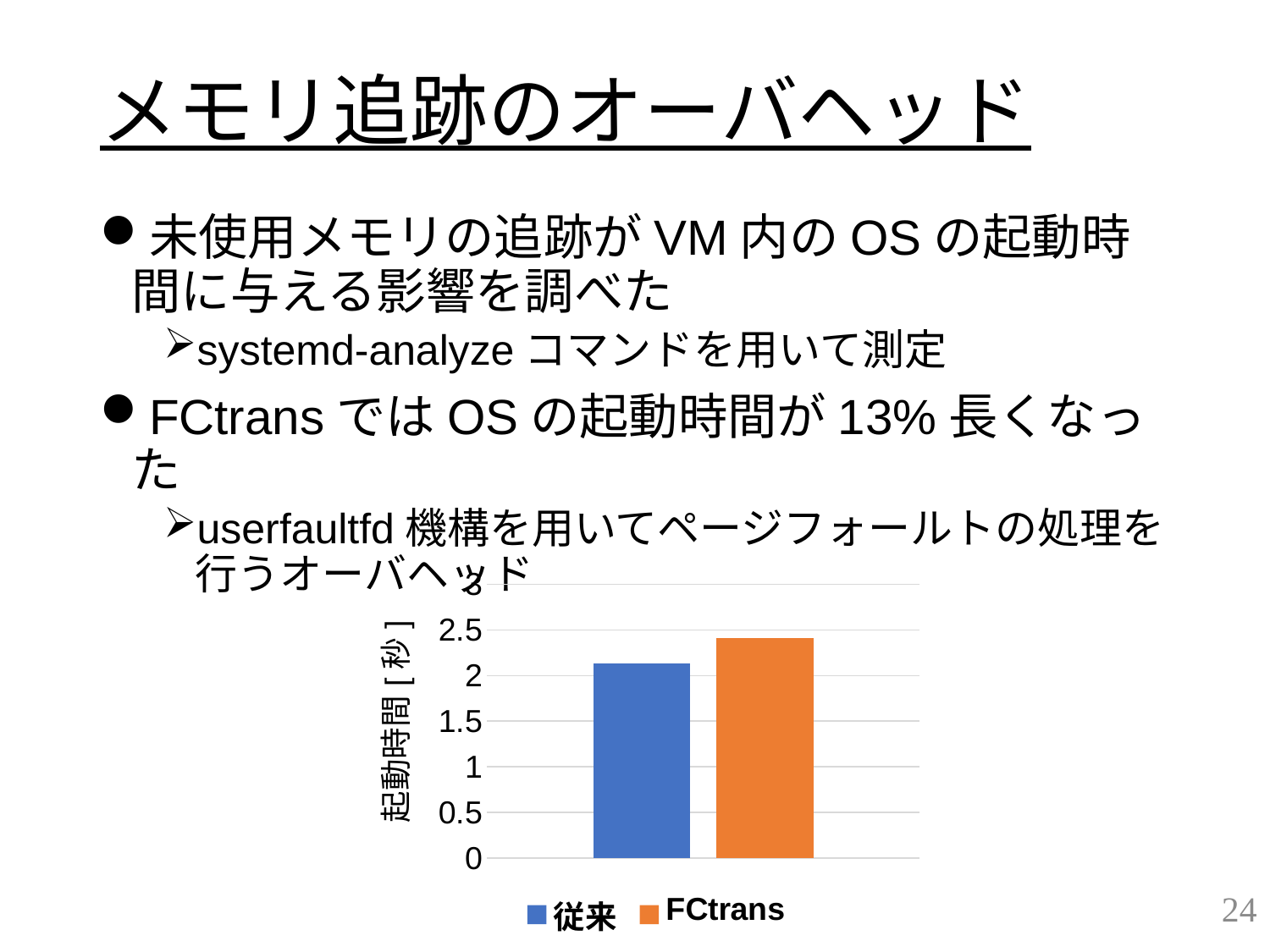
Is the value for 従来 greater or less than 2.5? less Is the value for 従来 greater or less than 2? greater Is the value for FCtrans greater or less than 2.5? less What kind of chart is shown on the slide? bar chart Which colour represents FCtrans in the chart legend? orange Is the 起動時間 for FCtrans larger or smaller than that for 従来? larger Which series has the higher 起動時間 in the chart? FCtrans How many series does the chart legend list? 2 What is the label of the vertical axis of the chart? 起動時間 [秒] How many bars are plotted in the chart? 2 Which series has the lower 起動時間 in the chart? 従来